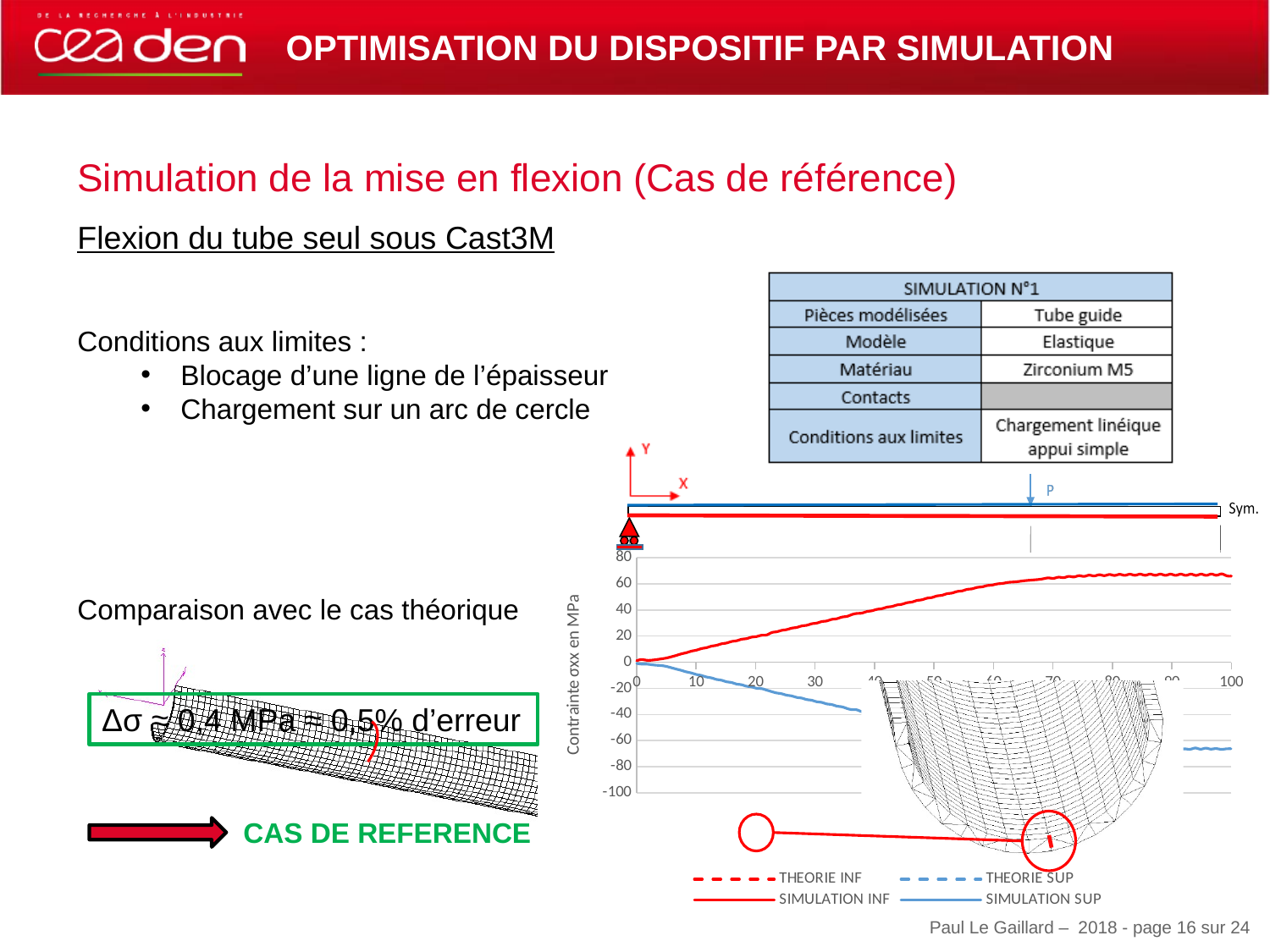
How many series does the legend of the stress chart list? 4 What kind of chart is shown at the bottom right of the slide? line chart Does the SIMULATION SUP (blue) series rise or fall as x increases from 0 to 30? fall Does the SIMULATION INF (red) series rise or fall as x increases from 0 to 100? rise At x = 30, which series has the larger value, SIMULATION INF or SIMULATION SUP? SIMULATION INF What is the lowest tick value shown on the y axis of the stress chart? -100 What is the highest tick value shown on the x axis of the stress chart? 100 Which series in the stress chart is drawn as a solid blue line? SIMULATION SUP Is the value of the SIMULATION SUP series at x = 30 greater or less than -20? less Is the value of the SIMULATION INF series at x = 30 greater or less than 20? greater Is the value of the SIMULATION INF series at x = 100 greater or less than 60? greater What is the label of the y axis of the stress chart? Contrainte σxx en MPa